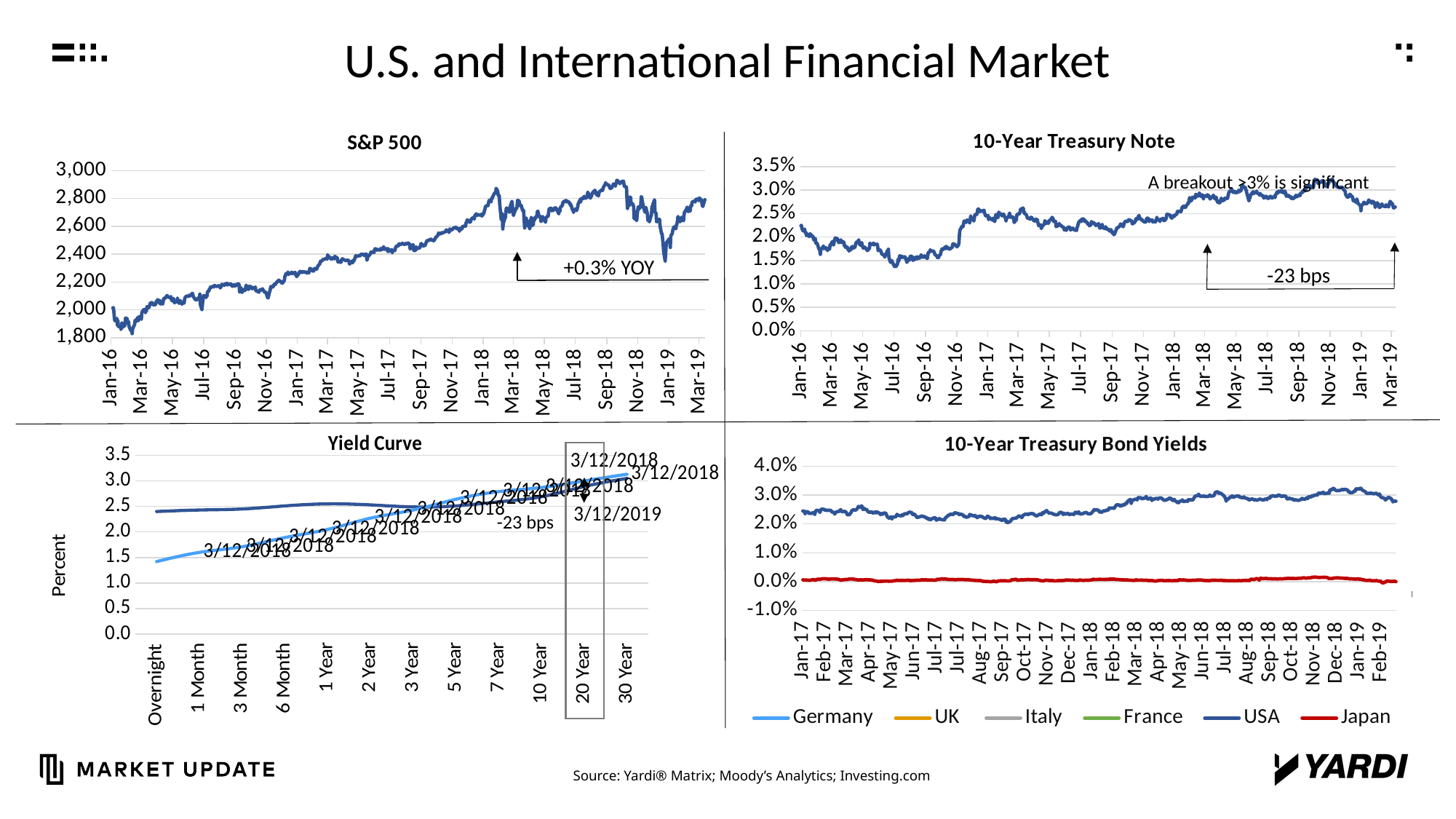
In the 10-Year Treasury Note chart, is the value at Mar-19 greater or less than 2.0%? greater What kind of chart is the S&P 500 chart? Line chart In the S&P 500 chart, what year-over-year change is annotated? +0.3% YOY In the Yield Curve chart, is the Overnight value for 3/12/2018 greater or less than 2.0? less How many series does the legend of the 10-Year Treasury Bond Yields chart list? 6 In the Yield Curve chart, does the 3/12/2018 line rise or fall from Overnight to 30 Year? Rise In the 10-Year Treasury Bond Yields chart, which is higher at Jan-19, USA or Japan? USA In the S&P 500 chart, does the index generally rise or fall from Jan-16 to Mar-19? Rise In the S&P 500 chart, is the value at Mar-19 greater or less than 2,600? greater How many maturity categories are shown on the x axis of the Yield Curve chart? 12 In the 10-Year Treasury Note chart, what change in basis points is annotated between Mar-18 and Mar-19? -23 bps